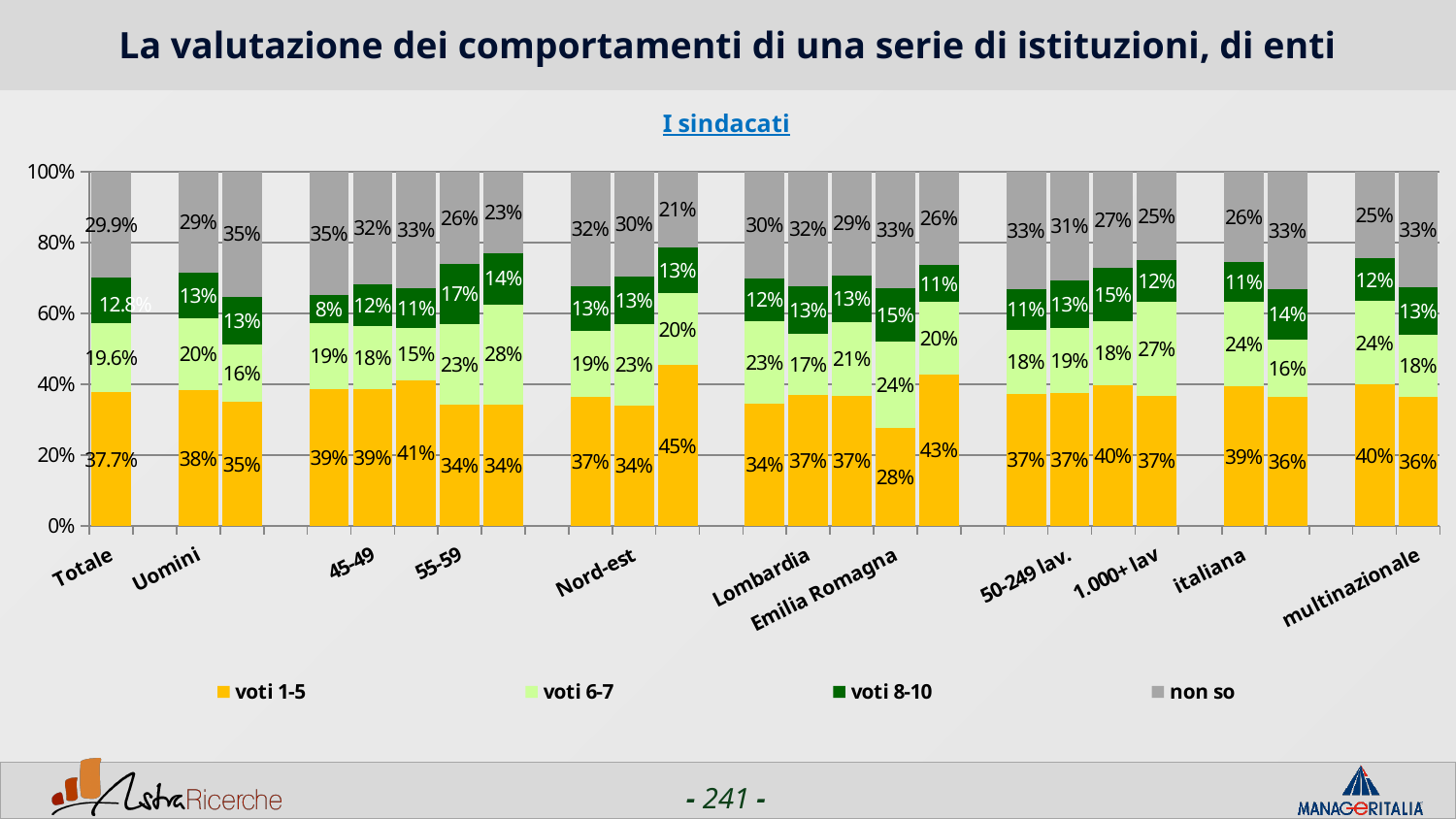
What kind of chart is shown on the slide? stacked bar chart What is the subtitle of the chart, shown above it? I sindacati For Totale, which is larger: 'voti 1-5' or 'non so'? voti 1-5 What is the value of 'voti 8-10' for Totale? 12.8% What is the value of 'voti 6-7' for Uomini? 20% What is the value of 'voti 1-5' for Totale? 37.7% For Totale, what is the difference between 'voti 1-5' and 'voti 6-7'? 18.1 percentage points What is the value of 'voti 1-5' for Emilia Romagna? 28% What is the value of 'non so' for Totale? 29.9% How many series does the legend list? 4 What is the value of 'voti 1-5' for Uomini? 38% What are the four legend entries of the chart? voti 1-5, voti 6-7, voti 8-10, non so